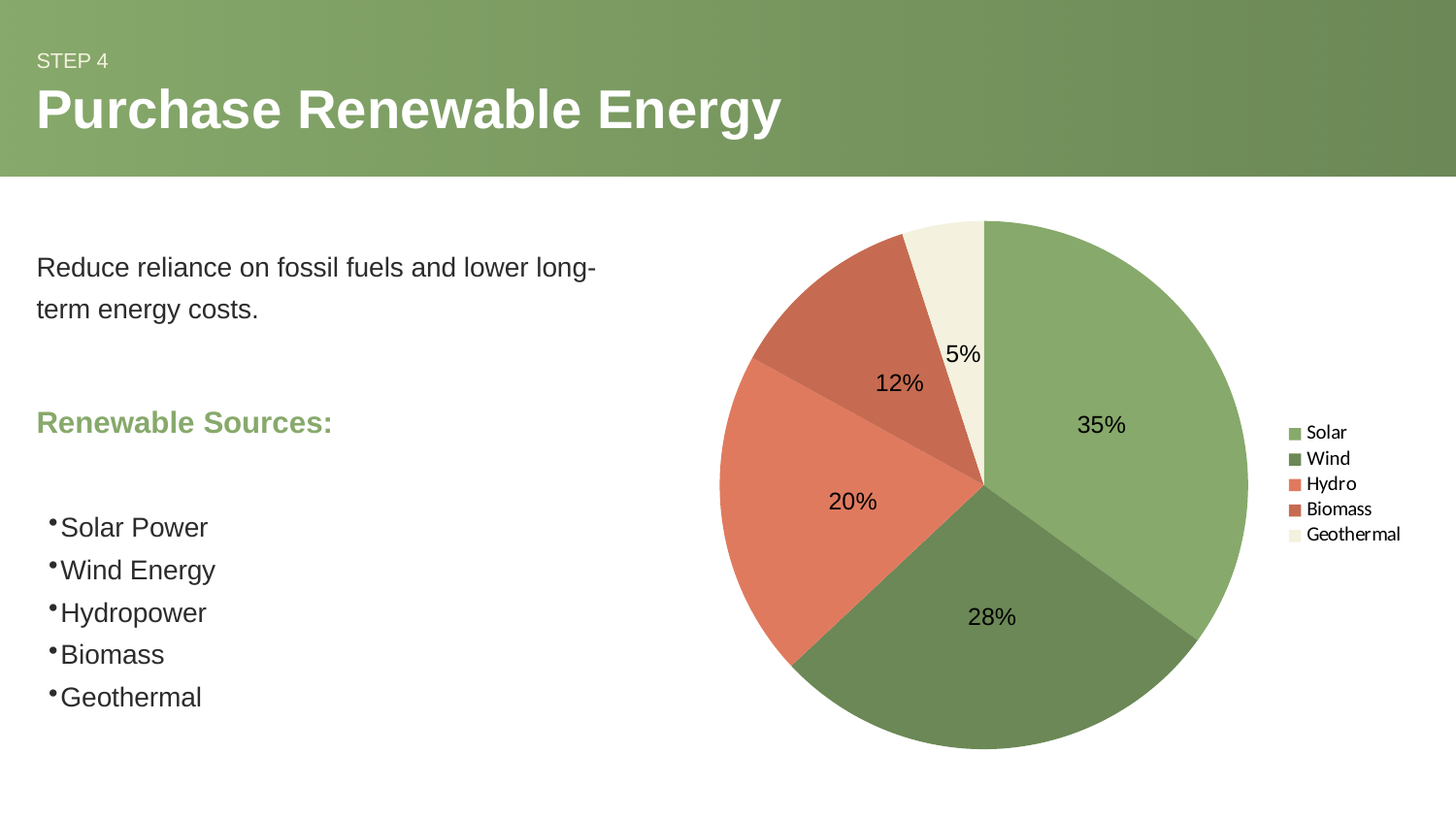
Which category has the largest slice of the pie? Solar What share of the pie does Biomass have? 12% Which category has the smallest slice of the pie? Geothermal How many categories does the pie chart have? 5 What share of the pie does Hydro have? 20% What is the difference between the Solar and Wind shares? 7% What type of chart is shown on the slide? pie chart What share of the pie does Wind have? 28% What share of the pie does Geothermal have? 5% Which is larger, the Hydro share or the Biomass share? Hydro Which category is shown in the lightest (cream) colour in the legend? Geothermal What share of the pie does Solar have? 35%